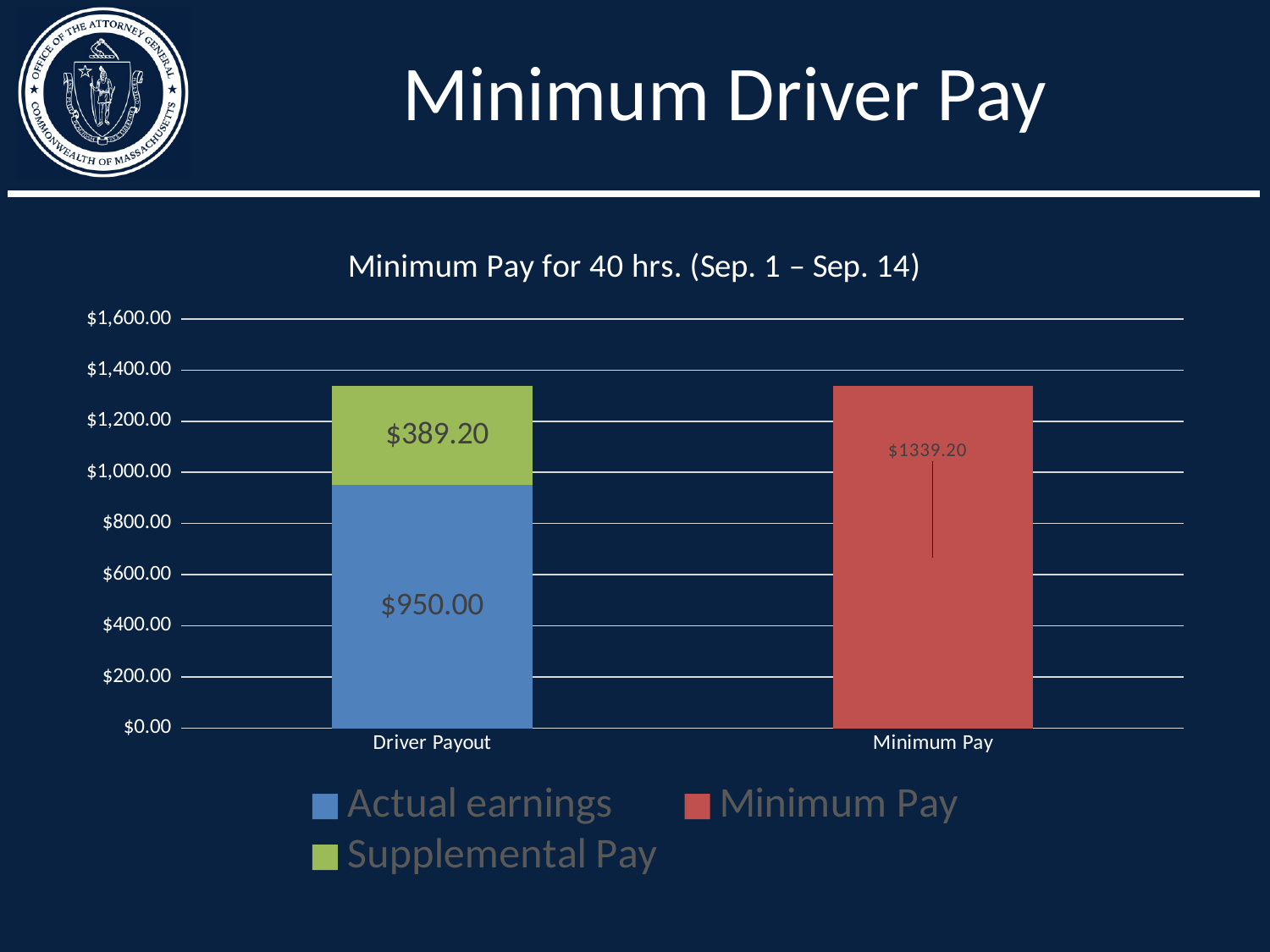
How many categories are shown on the x axis? 2 How many series does the legend list? 3 Which is larger in the Driver Payout bar, Actual earnings or Supplemental Pay? Actual earnings What is the title of the chart? Minimum Pay for 40 hrs. (Sep. 1 – Sep. 14) What is the value of the Actual earnings segment for Driver Payout? $950.00 Is the Actual earnings segment greater or less than $1,000.00? less What is the value of the Supplemental Pay segment for Driver Payout? $389.20 What is the value shown for the Minimum Pay bar? $1339.20 What kind of chart is shown on the slide? Stacked bar chart What is the difference between the Actual earnings and Supplemental Pay segments of the Driver Payout bar? $560.80 What is the total of the stacked Driver Payout bar? $1,339.20 Is the value of the Minimum Pay bar greater or less than $1,200.00? greater